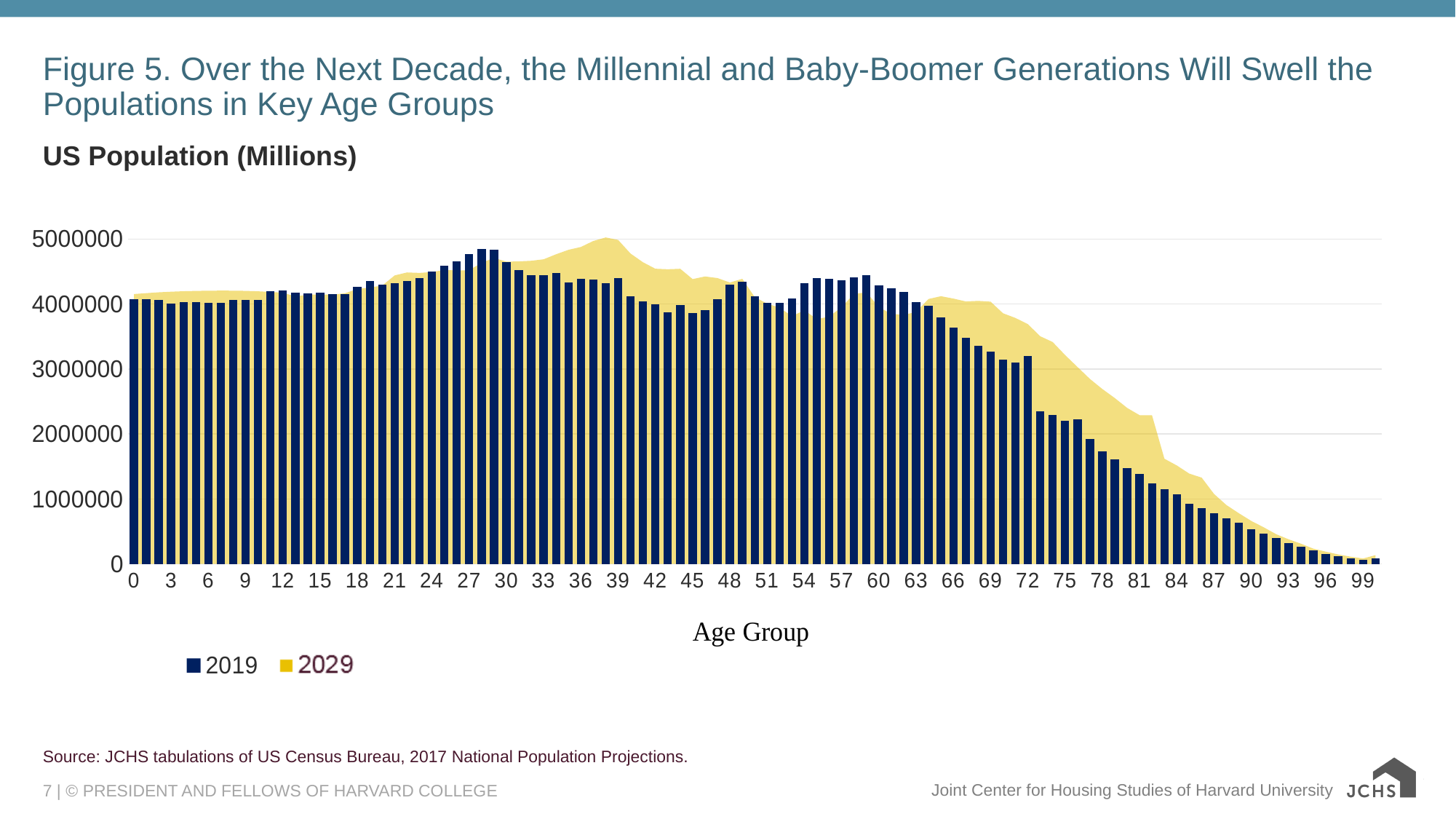
Is the 2019 value for age 78 greater or less than 2000000? less Which is larger, the 2019 value for age 27 or the 2019 value for age 72? age 27 How many series does the legend list? 2 At age 75, which series has the larger value, 2019 or 2029? 2029 What kind of chart is used to show the 2019 series? bar chart Is the 2019 value for age 27 greater or less than 4000000? greater Is the 2019 value for age 66 greater or less than 3000000? greater What are the two series shown in the legend? 2019 and 2029 What is the label on the x axis? Age Group Do the 2019 values rise or fall as age increases from 72 to 99? fall